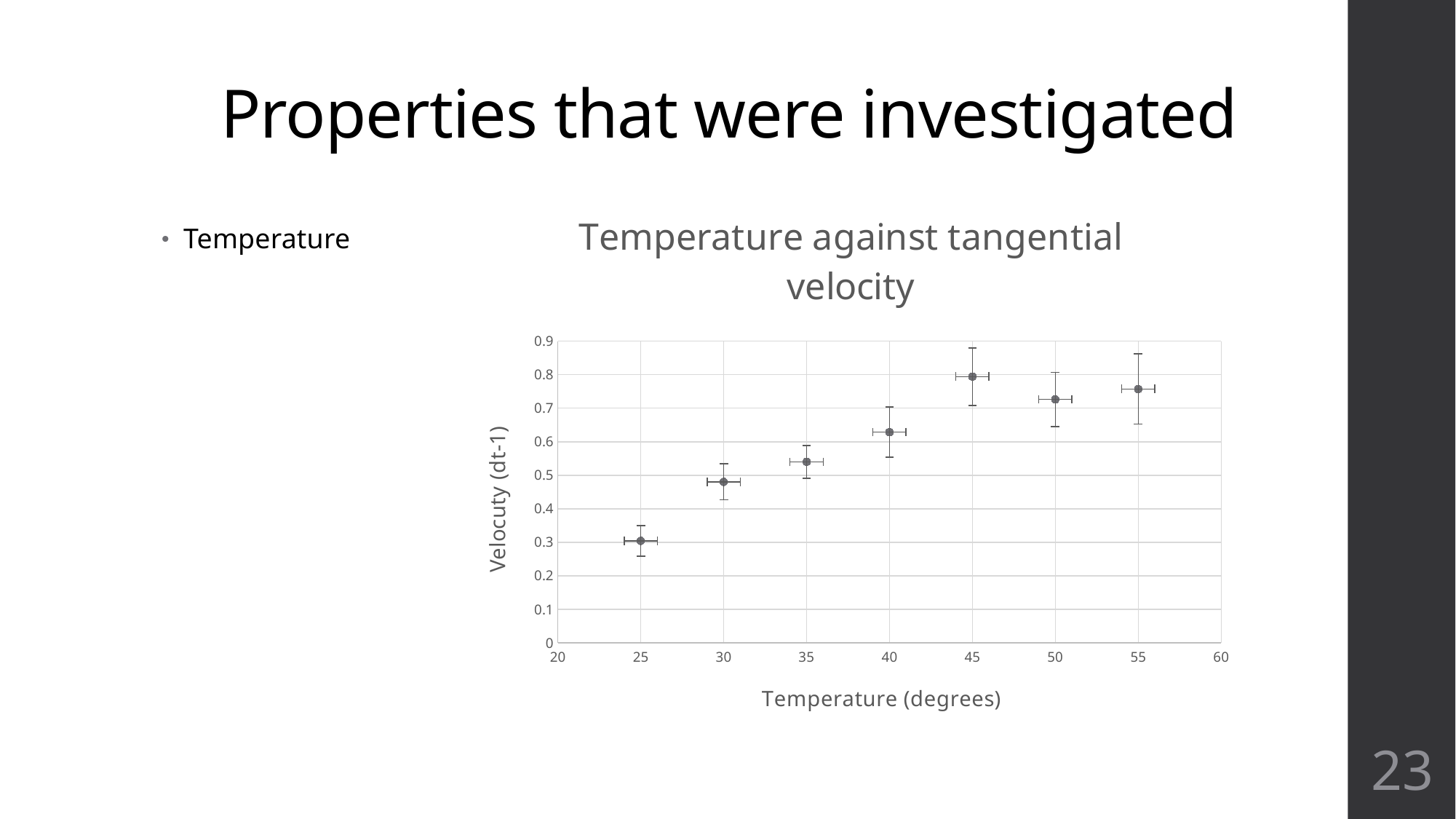
Is the velocity at a temperature of 30 greater or less than 0.4? greater What kind of chart is shown on the slide? scatter chart Do the velocity values generally rise or fall as temperature increases from 25 to 45? rise Which has the larger velocity: the point at temperature 40 or the point at temperature 30? 40 At which temperature is the plotted velocity highest? 45 How many data points are plotted on the chart? 7 Is the velocity at a temperature of 40 greater or less than 0.5? greater What is the title of the chart? Temperature against tangential velocity At which temperature is the plotted velocity lowest? 25 Is the velocity at a temperature of 45 greater or less than 0.7? greater What is the label of the x axis of the chart? Temperature (degrees)